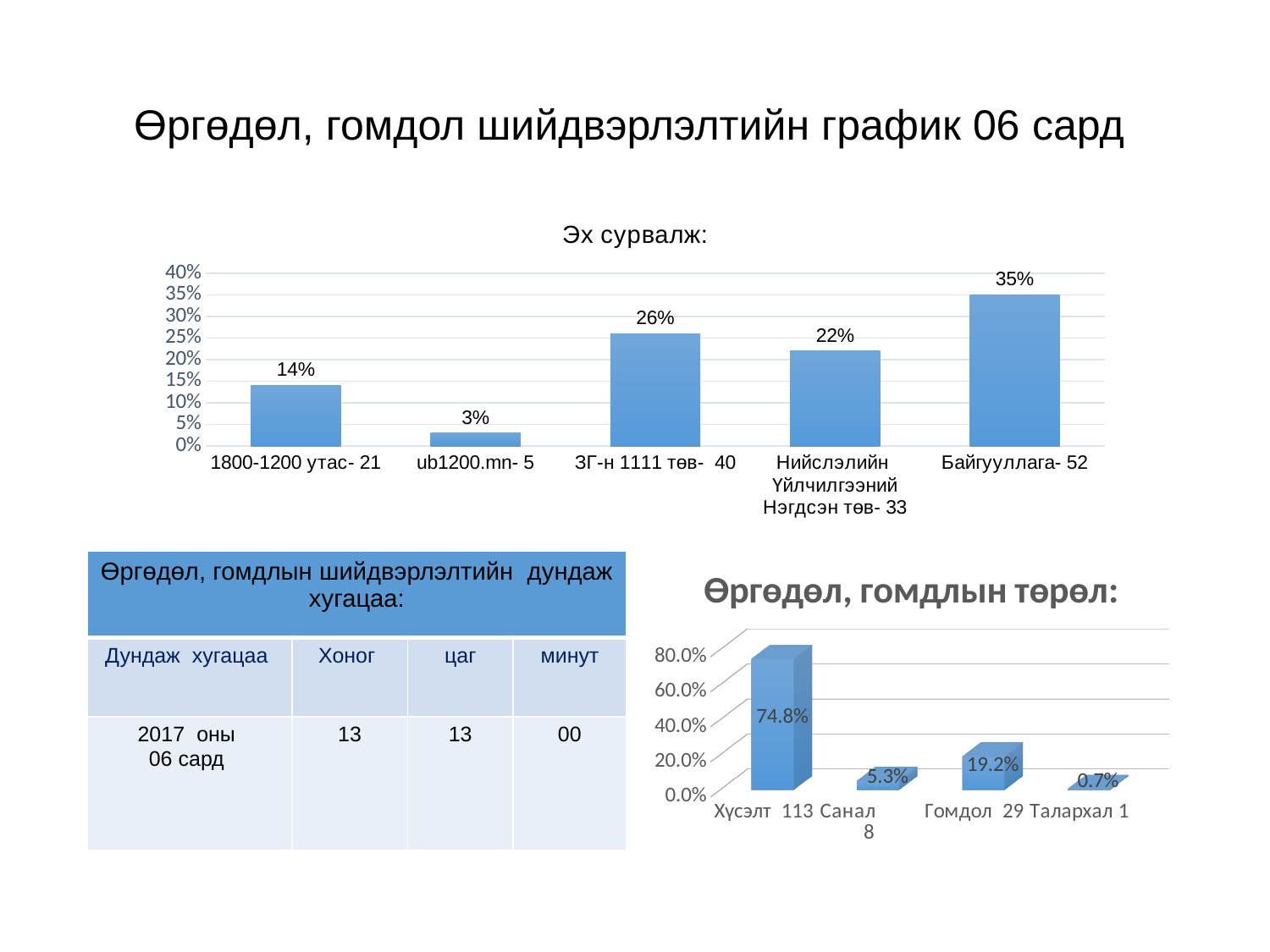
In the chart titled "Өргөдөл, гомдлын төрөл:", what is the value for "Хүсэлт 113"? 74.8% In the chart titled "Эх сурвалж:", is the value for "Нийслэлийн Үйлчилгээний Нэгдсэн төв- 33" greater or less than 20%? greater In the chart titled "Өргөдөл, гомдлын төрөл:", which category has the lowest value? Талархал 1 In the chart titled "Эх сурвалж:", what is the difference between the values for "ЗГ-н 1111 төв- 40" and "1800-1200 утас- 21"? 12% In the chart titled "Өргөдөл, гомдлын төрөл:", what is the value for "Гомдол 29"? 19.2% In the chart titled "Өргөдөл, гомдлын төрөл:", which is larger, the value for "Санал 8" or the value for "Гомдол 29"? Гомдол 29 In the chart titled "Эх сурвалж:", what is the value for "Байгууллага- 52"? 35% What kind of chart is the chart titled "Өргөдөл, гомдлын төрөл:"? bar chart In the chart titled "Эх сурвалж:", how many categories are shown? 5 In the chart titled "Эх сурвалж:", which category has the lowest value? ub1200.mn- 5 In the chart titled "Эх сурвалж:", which category has the highest value? Байгууллага- 52 In the chart titled "Эх сурвалж:", what is the value for "ub1200.mn- 5"? 3%